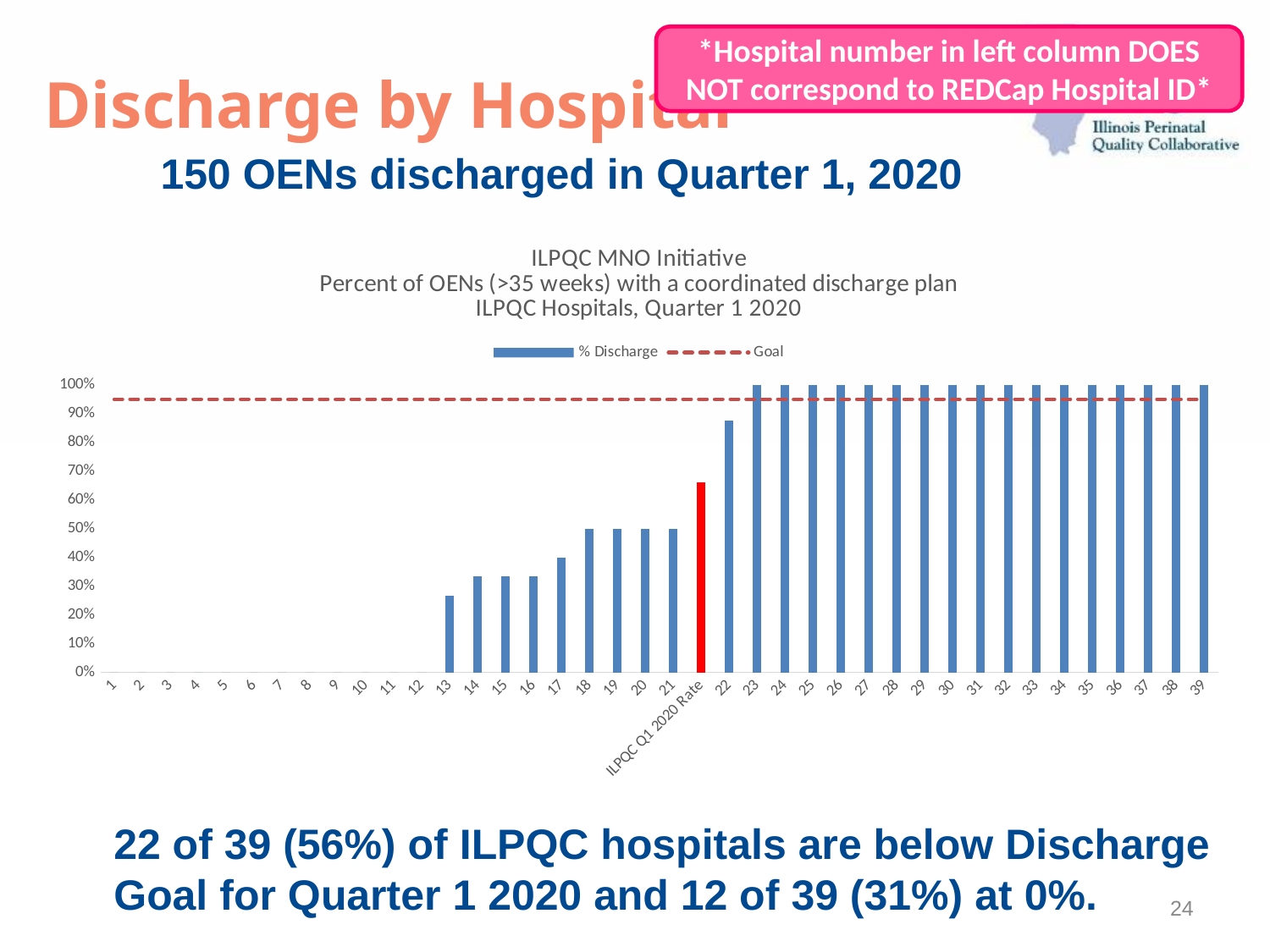
What are the two entries in the chart legend? % Discharge and Goal Is the % Discharge value for hospital 17 greater or less than 50%? less What kind of chart is shown on the slide? bar chart Is the % Discharge value for hospital 13 greater or less than 30%? less What is the % Discharge value for hospital 39? 100% What is the % Discharge value for hospital 1? 0% Is the % Discharge value for hospital 22 greater or less than 80%? greater How many series does the chart legend list? 2 What colour is the ILPQC Q1 2020 Rate bar? red Which has a higher % Discharge value, hospital 22 or hospital 17? hospital 22 Do the % Discharge values generally rise or fall moving from hospital 1 to hospital 39 along the x axis? rise